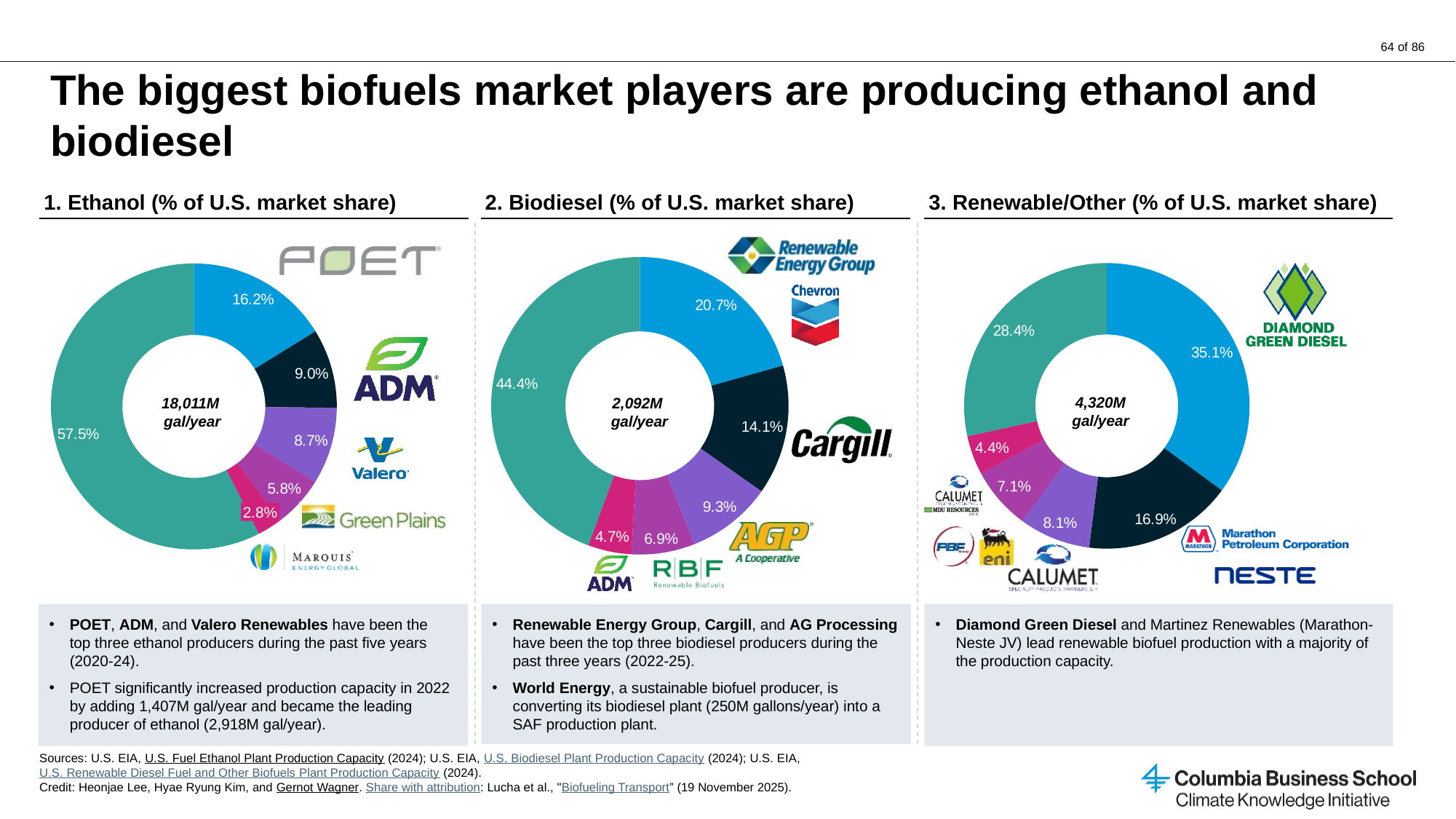
In the Renewable/Other chart, what is the difference in percentage points between the 35.1% slice and the 28.4% slice? 6.7 percentage points How many slices does the Ethanol chart contain? 6 What kind of chart is used on this slide for the three market share breakdowns? Donut (pie) chart What total production capacity is printed in the center of the Ethanol chart? 18,011M gal/year Which is larger: the largest slice in the Ethanol chart or the largest slice in the Biodiesel chart? The Ethanol chart's largest slice (57.5%) In the Biodiesel (% of U.S. market share) chart, what is the largest slice's share? 44.4% In the Biodiesel chart, what is the smallest slice's share? 4.7% What total production capacity is printed in the center of the Biodiesel chart? 2,092M gal/year In the Ethanol (% of U.S. market share) chart, what is the largest slice's share? 57.5% In the Renewable/Other chart, what is the smallest slice's share? 4.4% In the Ethanol chart, what is the smallest slice's share? 2.8% In the Renewable/Other (% of U.S. market share) chart, what is the largest slice's share? 35.1%